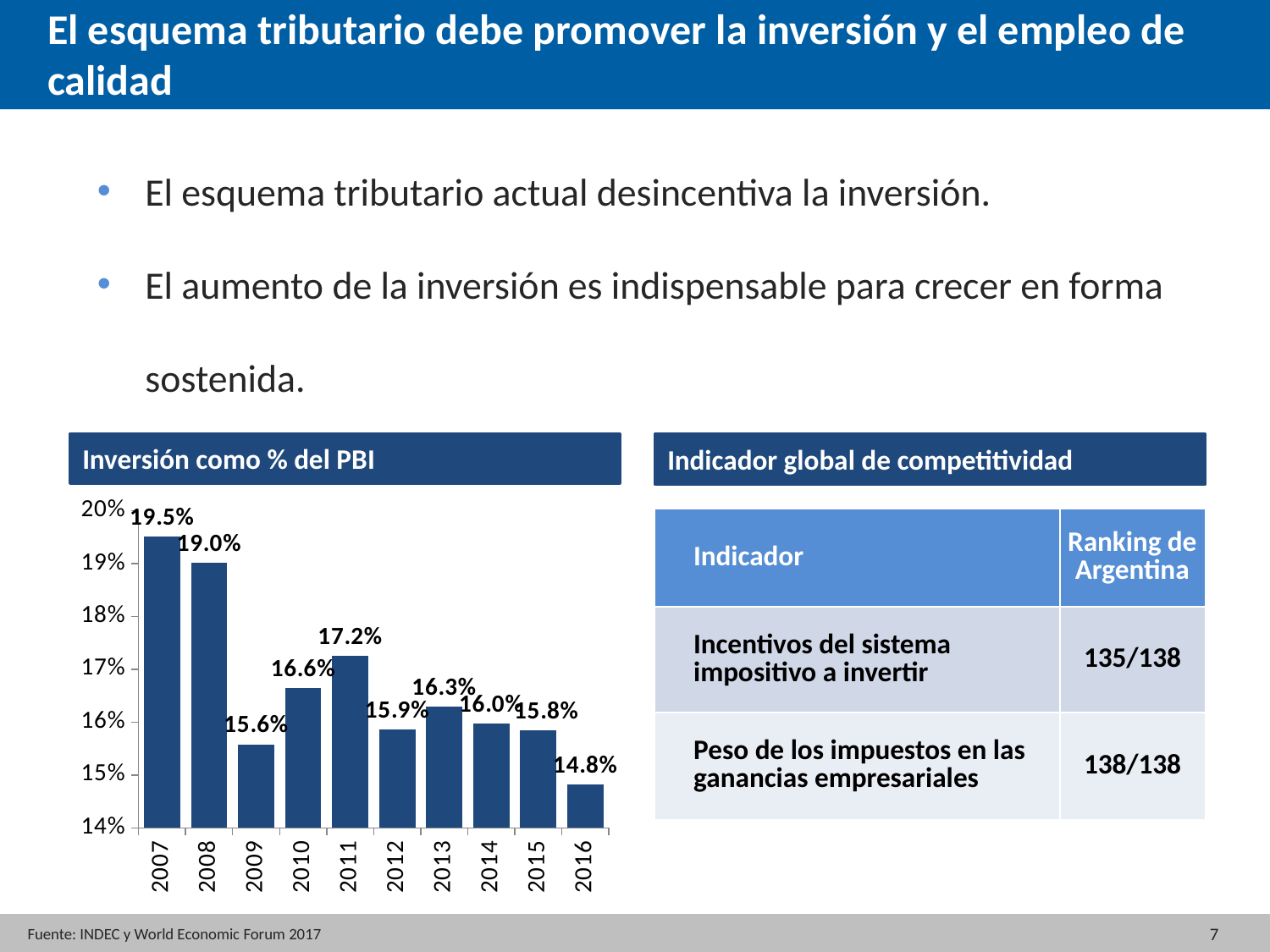
Is the value for 2009 in the 'Inversión como % del PBI' chart greater or less than 16%? less Which year has the highest value in the 'Inversión como % del PBI' chart? 2007 What kind of chart is 'Inversión como % del PBI'? bar chart What is the value for 2011 in the 'Inversión como % del PBI' chart? 17.2% What is the difference between the 2007 and 2016 values in the 'Inversión como % del PBI' chart? 4.7% How many years are shown on the x axis of the 'Inversión como % del PBI' chart? 10 In the 'Inversión como % del PBI' chart, which is larger, the value for 2010 or the value for 2013? 2010 In the 'Inversión como % del PBI' chart, do the values rise or fall from 2007 to 2009? fall Which year has the lowest value in the 'Inversión como % del PBI' chart? 2016 What is the value for 2016 in the 'Inversión como % del PBI' chart? 14.8% What is the value for 2007 in the 'Inversión como % del PBI' chart? 19.5% What is the title of the chart on the slide? Inversión como % del PBI